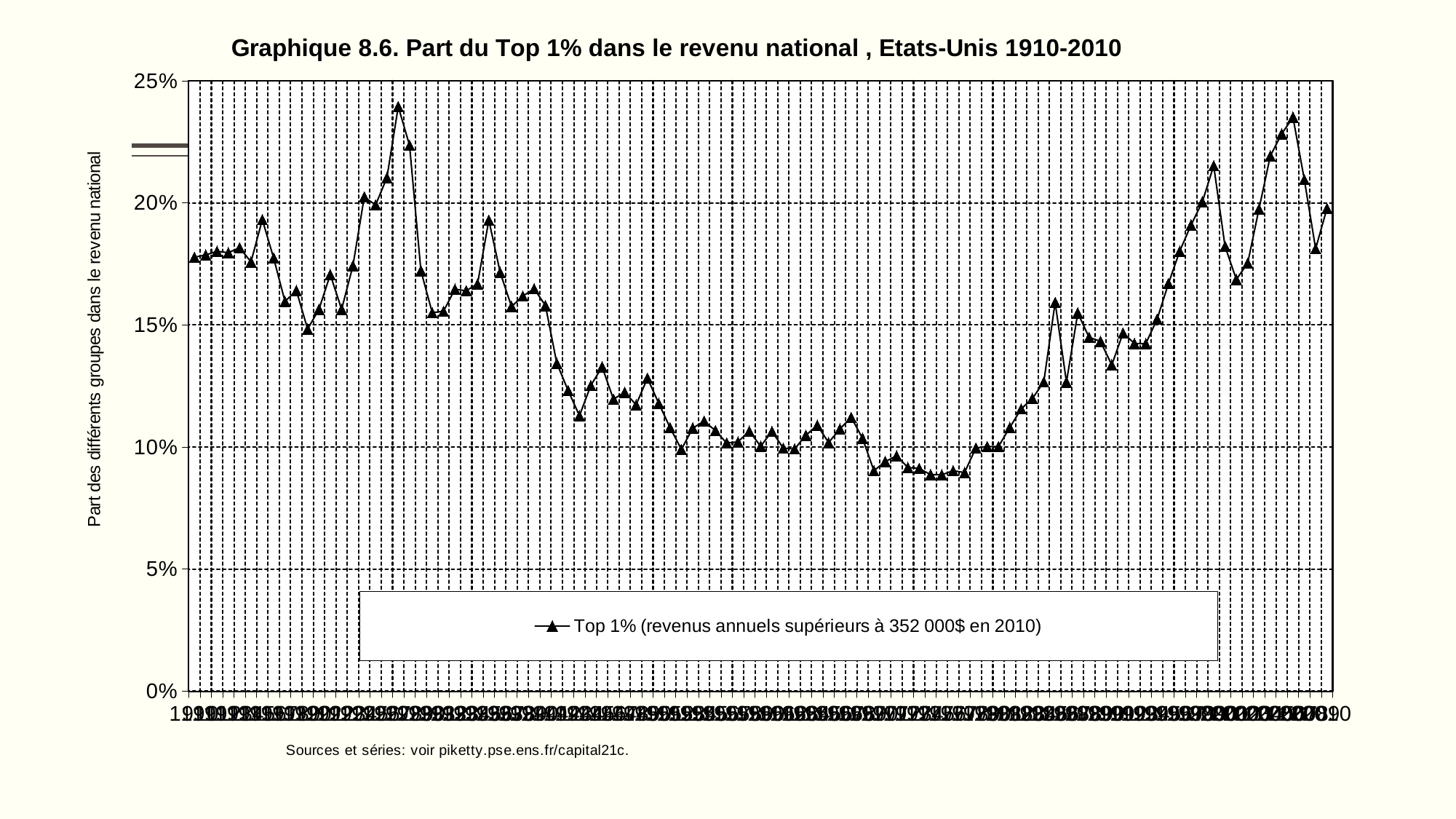
What kind of chart is shown on the slide? Line chart Over the rightmost stretch of the x axis (the final decades), does the series generally rise or fall? rise How many series does the legend list? 1 Is the value at the last point of the series (2010) greater or less than 15%? greater Is the lowest value reached by the series greater or less than 10%? less Is the value at the first point of the series (1910) greater or less than 15%? greater What is the title of the chart? Graphique 8.6. Part du Top 1% dans le revenu national , Etats-Unis 1910-2010 What is the legend entry for the plotted series? Top 1% (revenus annuels supérieurs à 352 000$ en 2010)